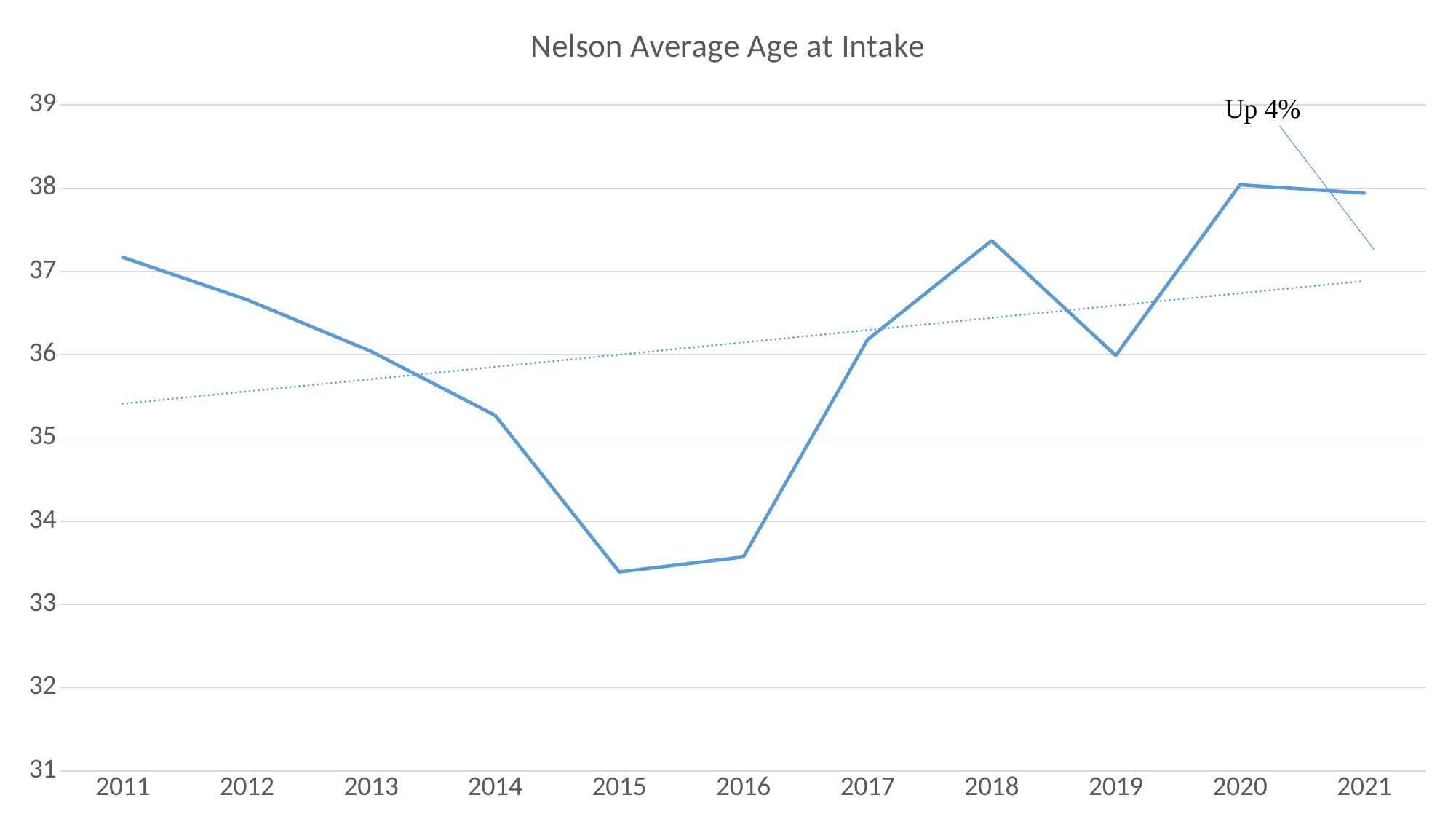
Which is larger, the value for 2018 or the value for 2019? 2018 Is the value for 2015 greater or less than 34? less Is the value for 2014 greater or less than 35? greater How many years are plotted along the x axis? 11 What does the annotation near the 2021 point say? Up 4% What kind of chart is shown on the slide? Line chart Is the value for 2011 greater or less than 37? greater Which year has the lowest average age at intake? 2015 What is the title of the chart? Nelson Average Age at Intake Which year has the highest average age at intake? 2020 Do the values rise or fall from 2011 to 2015? fall